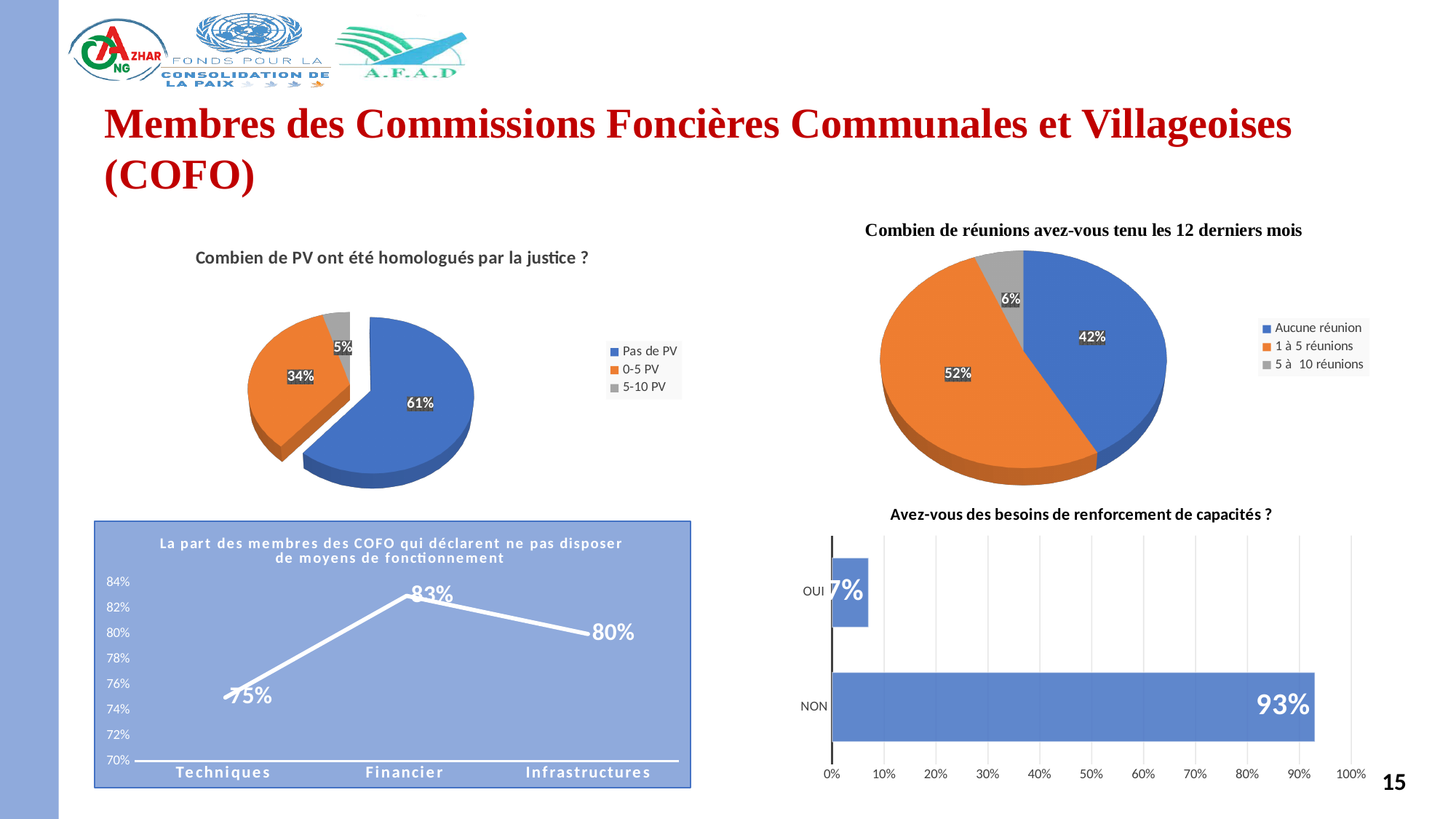
In the chart 'La part des membres des COFO qui déclarent ne pas disposer de moyens de fonctionnement', how many categories are shown on the x axis? 3 In the chart 'Combien de réunions avez-vous tenu les 12 derniers mois', which category has the largest slice? 1 à 5 réunions What kind of chart is 'Avez-vous des besoins de renforcement de capacités ?'? Bar chart In the chart 'Combien de PV ont été homologués par la justice ?', what share is labelled for 'Pas de PV'? 61% In the chart 'Combien de réunions avez-vous tenu les 12 derniers mois', what share is shown for '1 à 5 réunions'? 52% In the chart 'Combien de PV ont été homologués par la justice ?', how many entries does the legend list? 3 In the chart 'Combien de PV ont été homologués par la justice ?', which category has the smallest slice? 5-10 PV In the chart 'Combien de réunions avez-vous tenu les 12 derniers mois', what is the difference between 'Aucune réunion' and '5 à 10 réunions'? 36% In the chart 'La part des membres des COFO qui déclarent ne pas disposer de moyens de fonctionnement', which category has the lowest value? Techniques In the chart 'La part des membres des COFO qui déclarent ne pas disposer de moyens de fonctionnement', what is the value for 'Financier'? 83% What kind of chart is 'Combien de réunions avez-vous tenu les 12 derniers mois'? Pie chart In the chart 'Avez-vous des besoins de renforcement de capacités ?', what is the value for 'NON'? 93%